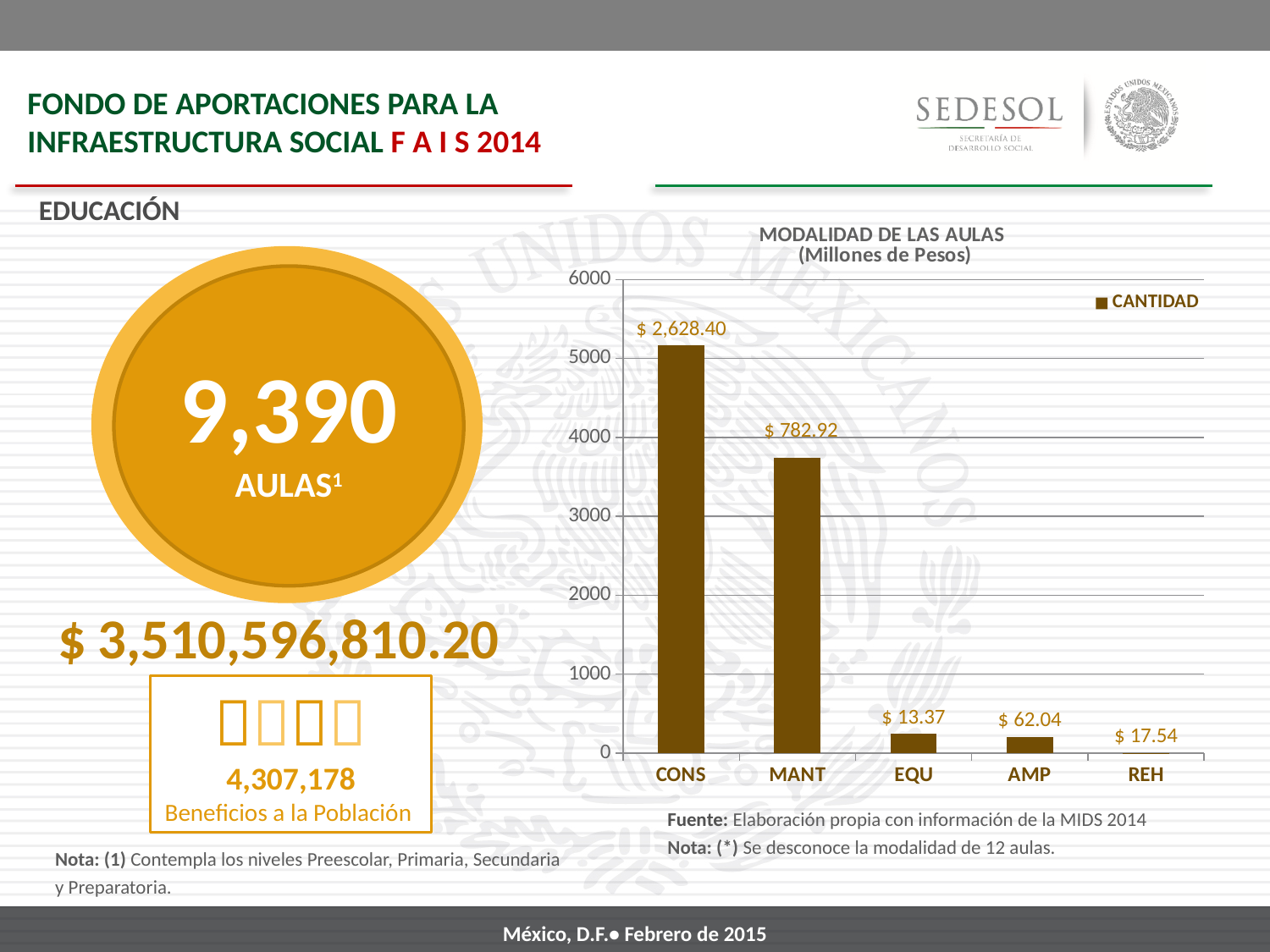
What is the value for AMP in the MODALIDAD DE LAS AULAS chart? $ 62.04 What is the value for CONS in the MODALIDAD DE LAS AULAS chart? $ 2,628.40 What is the value for REH in the MODALIDAD DE LAS AULAS chart? $ 17.54 Which category has the highest value in the MODALIDAD DE LAS AULAS chart? CONS How many categories are shown on the x axis of the MODALIDAD DE LAS AULAS chart? 5 What kind of chart is the MODALIDAD DE LAS AULAS chart? Bar chart How many series does the legend of the MODALIDAD DE LAS AULAS chart list? 1 What is the value for MANT in the MODALIDAD DE LAS AULAS chart? $ 782.92 What is the value for EQU in the MODALIDAD DE LAS AULAS chart? $ 13.37 What is the difference between the values for CONS and MANT in the MODALIDAD DE LAS AULAS chart? $ 1,845.48 Which is larger in the MODALIDAD DE LAS AULAS chart, AMP or REH? AMP